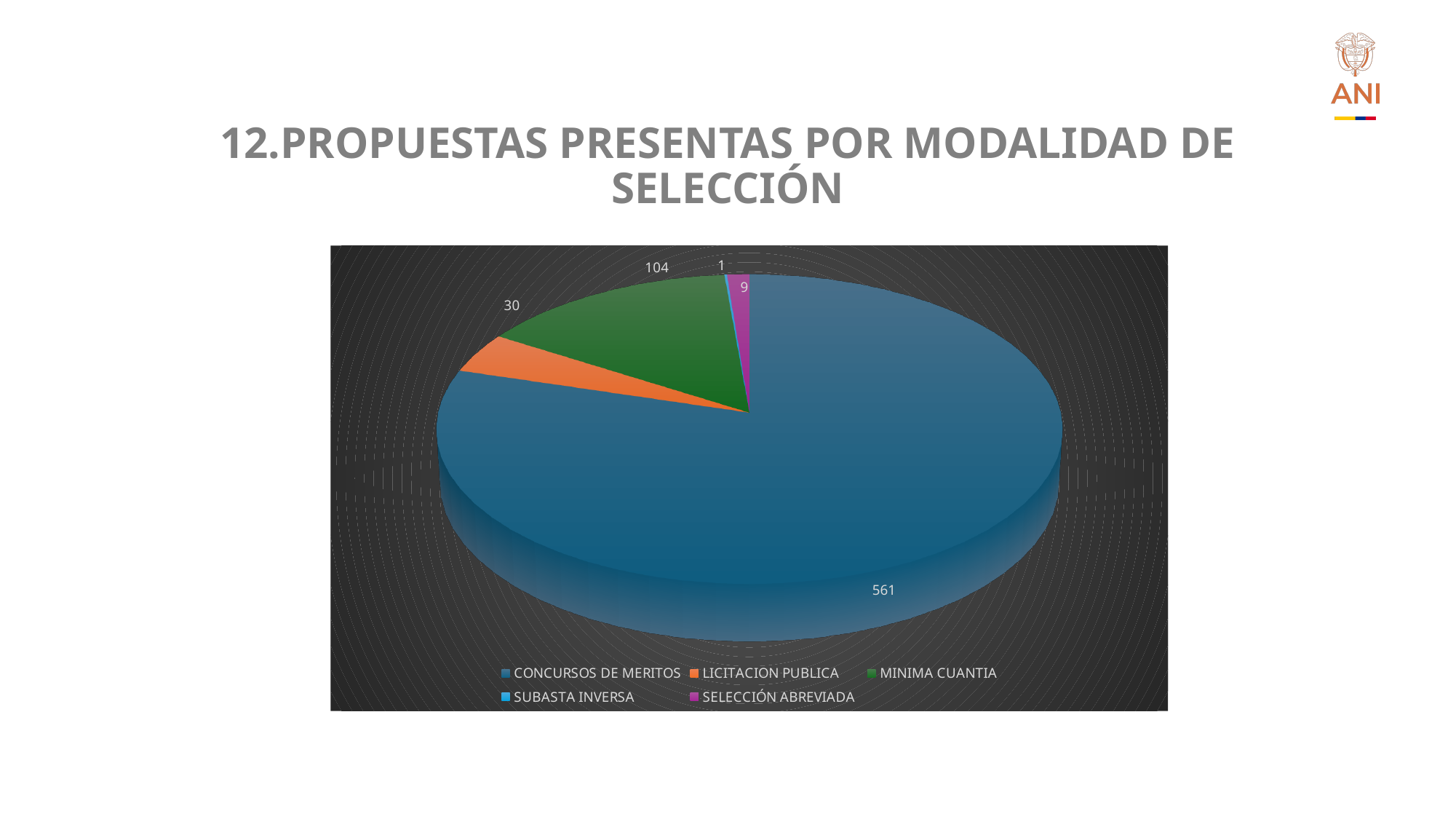
How many categories does the legend list? 5 What is the value for SUBASTA INVERSA? 1 What is the value for LICITACION PUBLICA? 30 Which category has the largest slice of the pie? CONCURSOS DE MERITOS Which is larger, the value for LICITACION PUBLICA or the value for SELECCIÓN ABREVIADA? LICITACION PUBLICA What is the value for CONCURSOS DE MERITOS? 561 What is the title of the slide containing the chart? 12.PROPUESTAS PRESENTAS POR MODALIDAD DE SELECCIÓN Which category has the smallest slice of the pie? SUBASTA INVERSA What is the value for SELECCIÓN ABREVIADA? 9 What is the value for MINIMA CUANTIA? 104 What kind of chart is shown on the slide? Pie chart What is the difference between the values for CONCURSOS DE MERITOS and MINIMA CUANTIA? 457